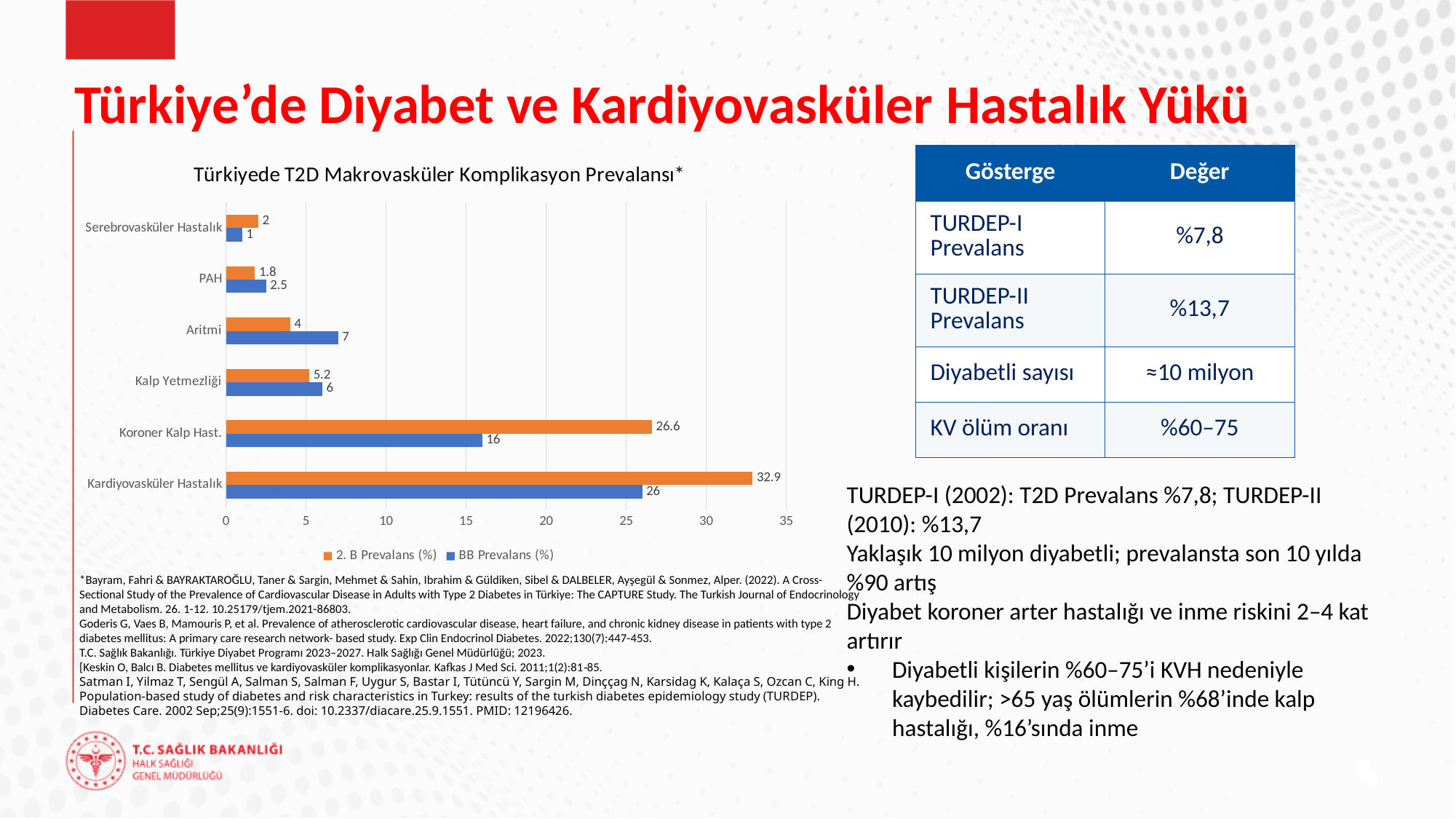
What is the BB Prevalans (%) value for Aritmi? 7 What is the BB Prevalans (%) value for Koroner Kalp Hast.? 16 What is the 2. B Prevalans (%) value for Kardiyovasküler Hastalık? 32.9 Which category has the highest 2. B Prevalans (%) value? Kardiyovasküler Hastalık For Aritmi, which series has the larger value: 2. B Prevalans (%) or BB Prevalans (%)? BB Prevalans (%) How many series does the legend list? 2 What is the 2. B Prevalans (%) value for PAH? 1.8 What is the title of the chart? Türkiyede T2D Makrovasküler Komplikasyon Prevalansı* How many categories are shown on the chart? 6 What is the difference between the 2. B Prevalans (%) and BB Prevalans (%) values for Koroner Kalp Hast.? 10.6 What kind of chart is shown on the slide? Bar chart Which category has the lowest BB Prevalans (%) value? Serebrovasküler Hastalık